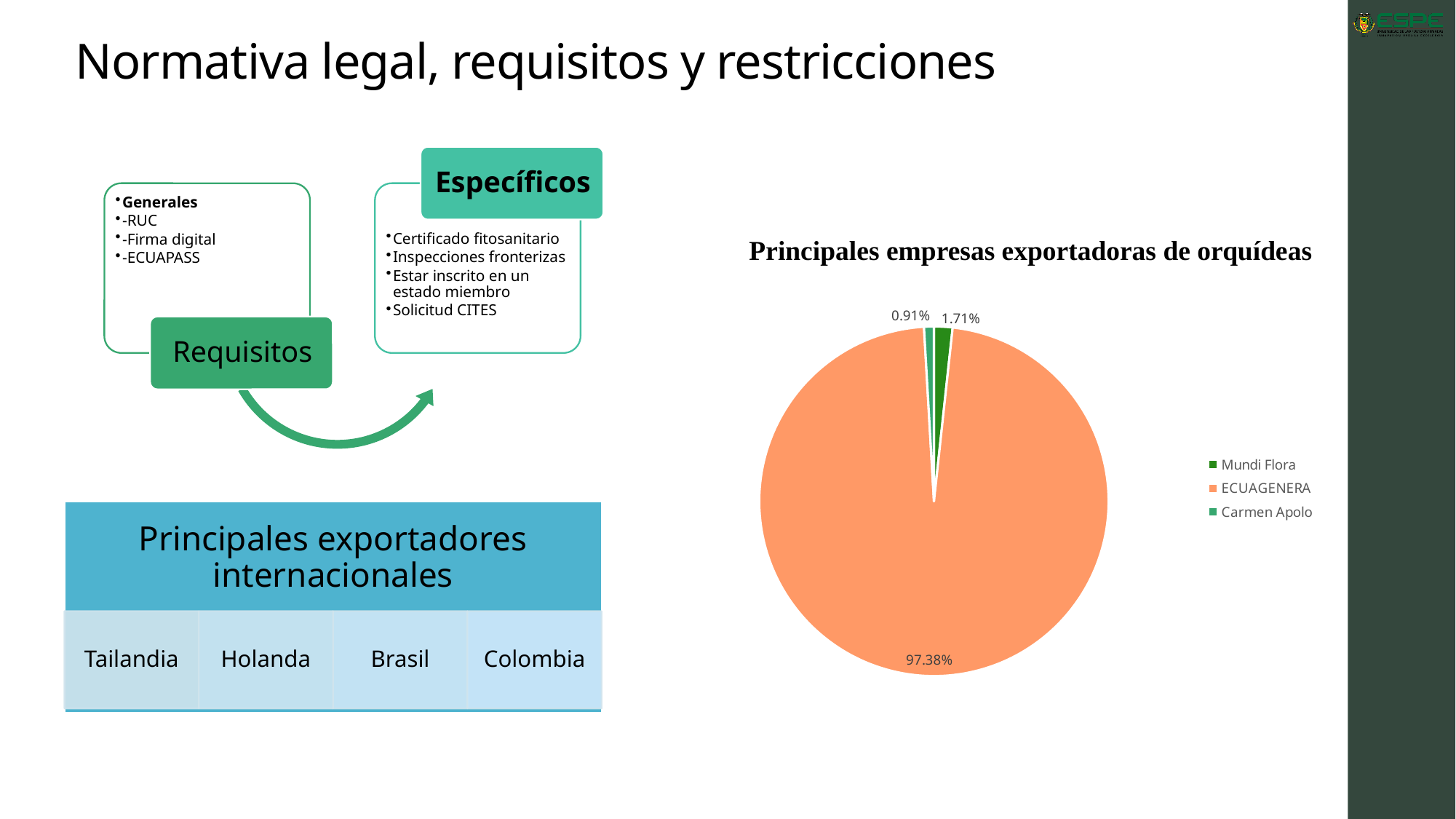
Which has a larger share, Mundi Flora or Carmen Apolo? Mundi Flora Which company has the smallest slice in the pie chart? Carmen Apolo How many slices does the pie chart have? 3 What share of the pie does ECUAGENERA hold? 97.38% How many companies does the legend of the pie chart list? 3 What is the title of the pie chart? Principales empresas exportadoras de orquídeas Which company is shown in orange in the pie chart? ECUAGENERA What share of the pie does Mundi Flora hold? 1.71% What kind of chart is shown on the slide? Pie chart What is the difference in percentage points between the shares of Mundi Flora and Carmen Apolo? 0.80% What share of the pie does Carmen Apolo hold? 0.91% Which company has the largest slice in the pie chart? ECUAGENERA